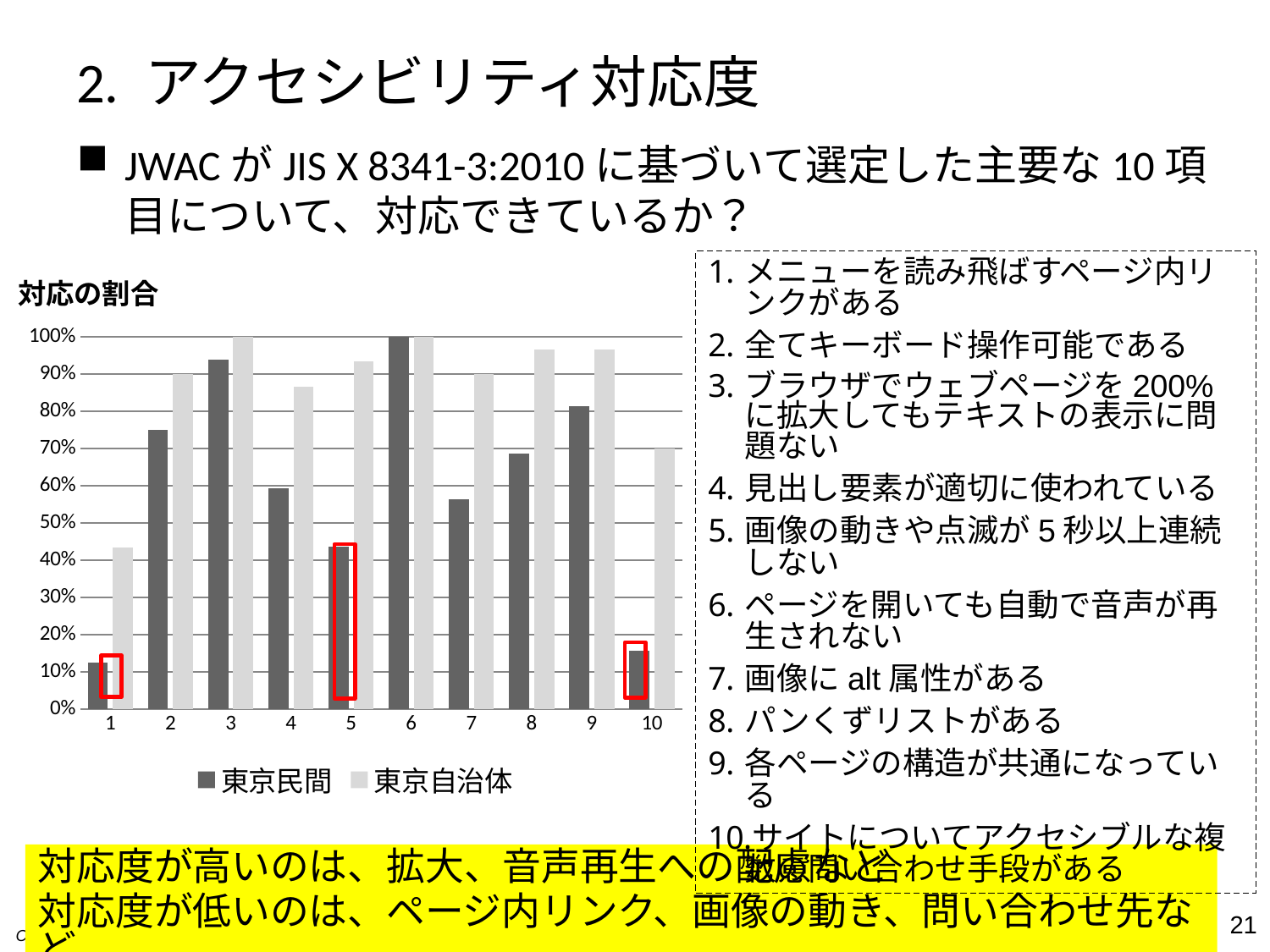
How many series does the chart legend list? 2 What is the value for 東京民間 at category 6? 100% How many categories are shown on the x axis of the chart? 10 What are the two series names listed in the chart legend? 東京民間, 東京自治体 What is the value for 東京自治体 at category 3? 100% What kind of chart is shown on the slide? bar chart Which category has the lowest value for 東京自治体? 1 Is the value for 東京民間 at category 2 greater or less than 70%? greater Which category has the highest value for 東京民間? 6 At category 1, which series has the larger value, 東京民間 or 東京自治体? 東京自治体 Is the value for 東京民間 at category 10 greater or less than 20%? less Which category has the lowest value for 東京民間? 1